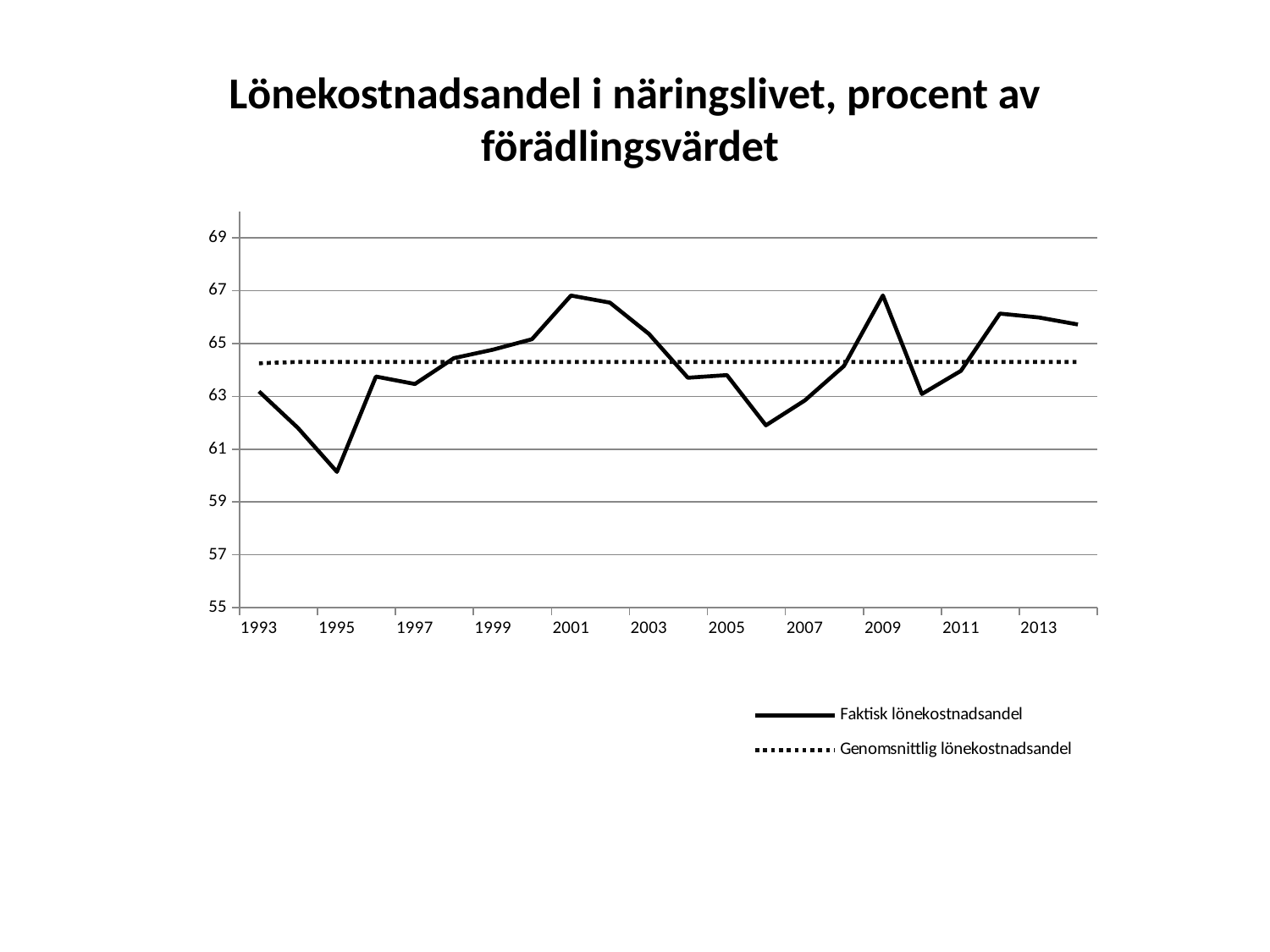
What kind of chart is shown on the slide? Line chart What is the title of the chart? Lönekostnadsandel i näringslivet, procent av förädlingsvärdet Does the Faktisk lönekostnadsandel rise or fall from 1993 to 1995? Fall In which year is the Faktisk lönekostnadsandel at its lowest? 1995 How many series does the legend list? 2 Which year has the higher Faktisk lönekostnadsandel, 1995 or 2006? 2006 Is the value of Faktisk lönekostnadsandel in 2009 greater or less than 65? greater Is the value of Faktisk lönekostnadsandel in 1995 greater or less than 61? less Is the Genomsnittlig lönekostnadsandel line greater or less than 65? less Which series is drawn with a dotted line? Genomsnittlig lönekostnadsandel